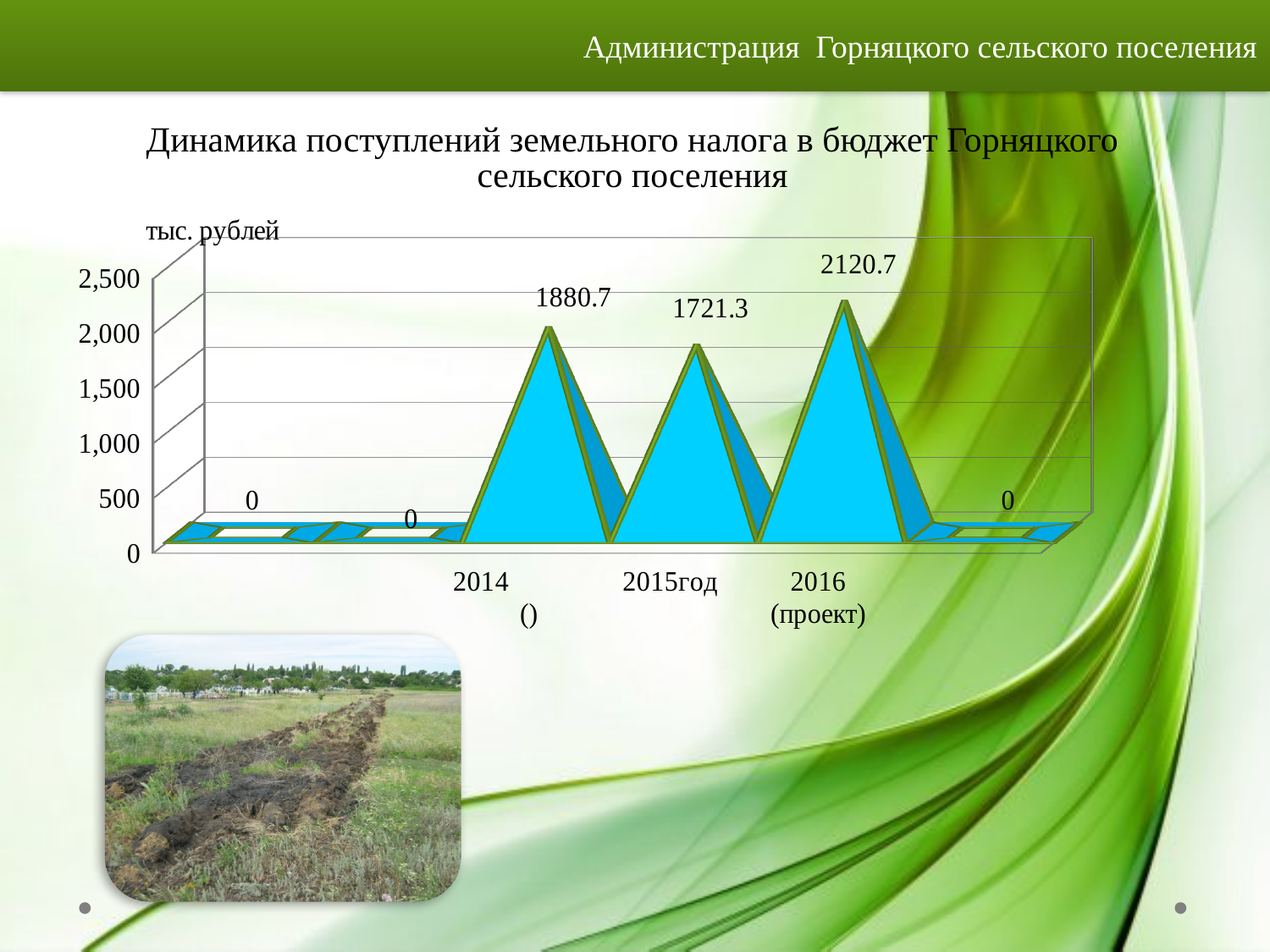
What is the value for 2016 (проект) on the chart? 2120.7 Is the value for 2015 greater or less than 2,000? less Which of the three labelled years has the lowest value? 2015 What is the value for 2014 on the chart? 1880.7 What is the difference between the values for 2016 (проект) and 2015? 399.4 Is the value for 2016 (проект) greater or less than 2,000? greater What is the title of the chart? Динамика поступлений земельного налога в бюджет Горняцкого сельского поселения Which year has the highest value on the chart? 2016 (проект) What unit is shown on the vertical axis of the chart? тыс. рублей Which is larger, the value for 2014 or the value for 2015? 2014 What is the difference between the values for 2014 and 2015? 159.4 What is the value for 2015 on the chart? 1721.3